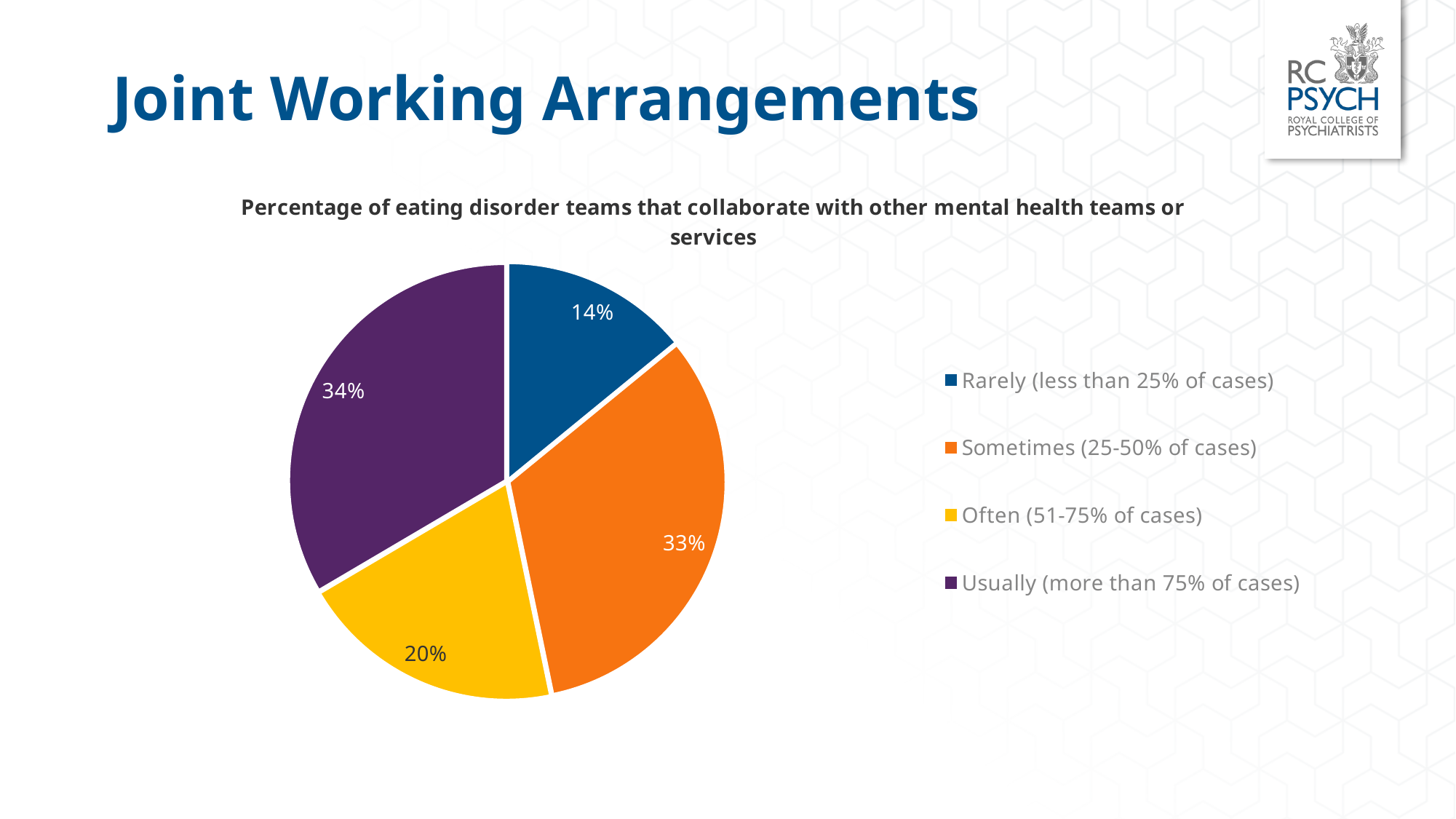
Which is larger: the share for 'Sometimes (25-50% of cases)' or the share for 'Often (51-75% of cases)'? Sometimes (25-50% of cases) How many categories does the pie chart show? 4 What kind of chart is shown on the slide? pie chart What percentage of teams fall into the 'Usually (more than 75% of cases)' category? 34% Which category has the smallest share of the pie? Rarely (less than 25% of cases) What percentage of eating disorder teams collaborate with other mental health teams 'Rarely (less than 25% of cases)'? 14% What percentage of teams fall into the 'Often (51-75% of cases)' category? 20% What is the difference in percentage points between the 'Usually' and 'Rarely' categories? 20 What colour is the slice for 'Often (51-75% of cases)'? yellow What percentage of teams fall into the 'Sometimes (25-50% of cases)' category? 33% Which category has the largest share of the pie? Usually (more than 75% of cases) What is the title of the chart? Percentage of eating disorder teams that collaborate with other mental health teams or services